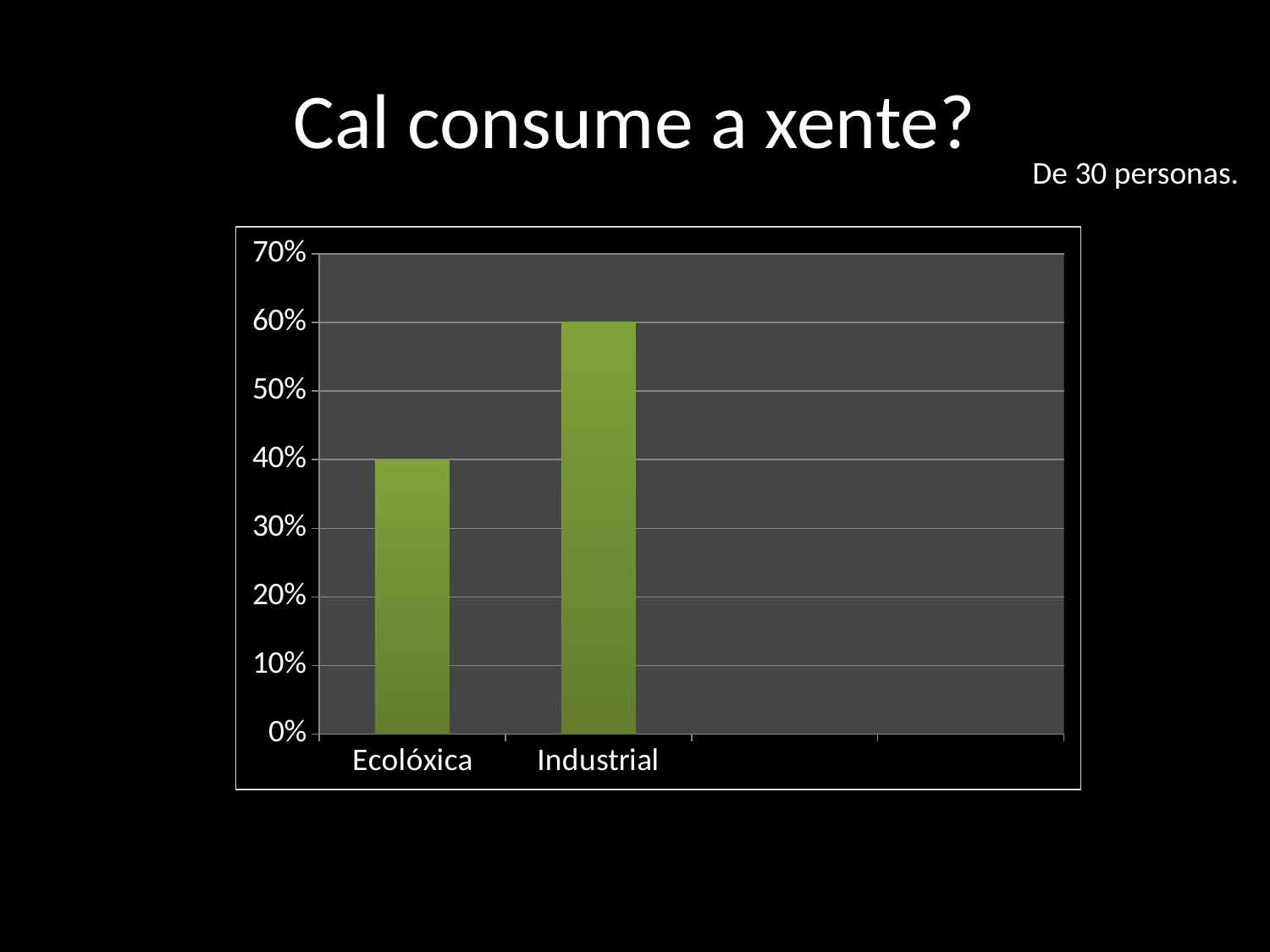
Is the value for Industrial greater or less than 50%? greater What is the value for Ecolóxica? 40% Which category has the lowest value? Ecolóxica What is the title of the slide? Cal consume a xente? What kind of chart is shown on the slide? Bar chart What is the highest value shown on the vertical axis? 70% How many categories are plotted in the chart? 2 Is the value for Ecolóxica greater or less than 50%? less Which category has the highest value? Industrial What is the value for Industrial? 60% Which is larger, the value for Ecolóxica or the value for Industrial? Industrial What is the difference between the values for Industrial and Ecolóxica? 20%